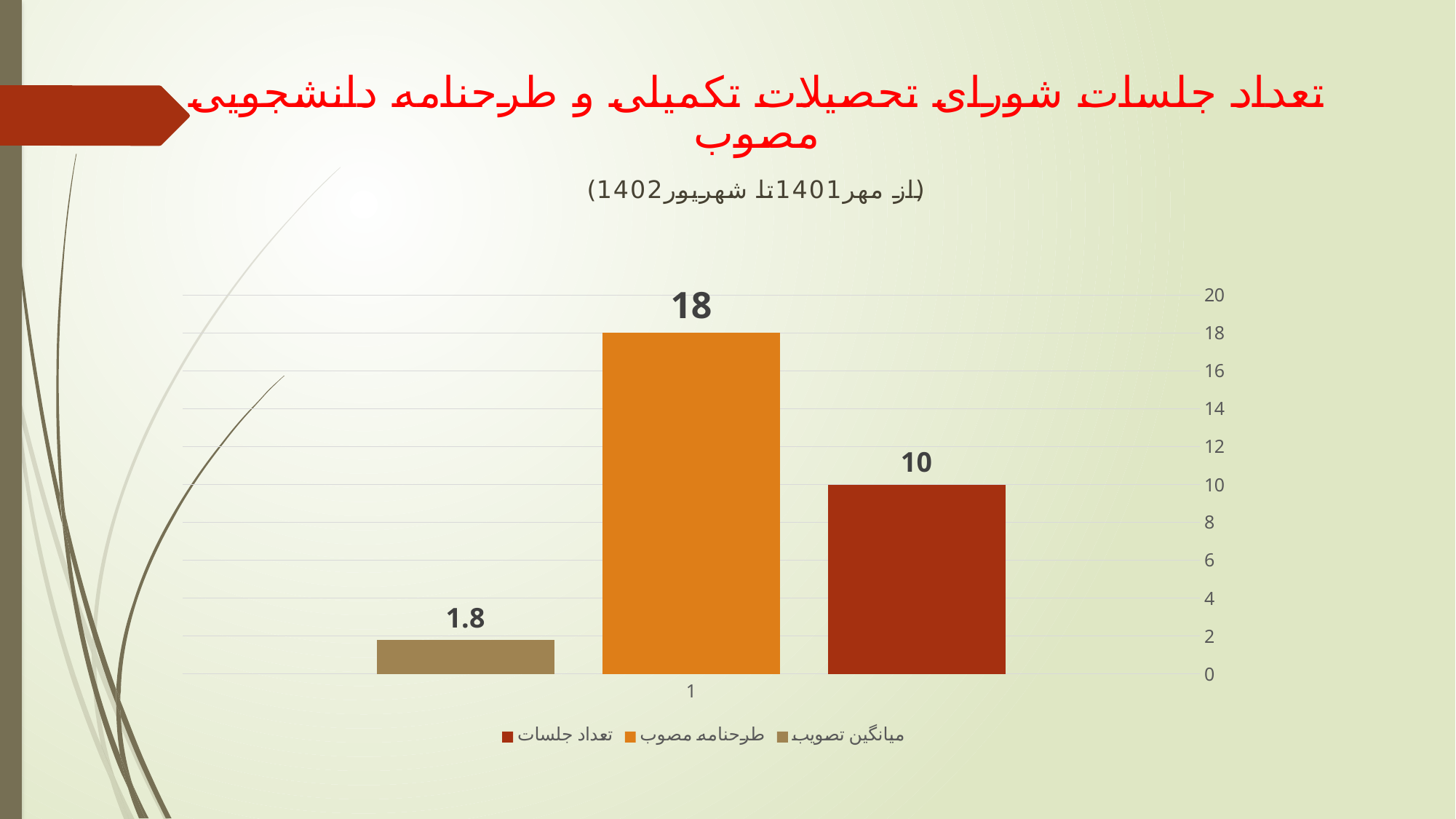
Which series has the lowest value? میانگین تصویب What is the value of the تعداد جلسات series? 10 What is the highest value shown on the vertical axis? 20 Which series has the highest value? طرحنامه مصوب What is the difference between the تعداد جلسات value and the میانگین تصویب value? 8.2 Which is larger, the value for تعداد جلسات or the value for میانگین تصویب? تعداد جلسات What is the value of the طرحنامه مصوب series? 18 What is the value of the میانگین تصویب series? 1.8 What is the difference between the طرحنامه مصوب value and the تعداد جلسات value? 8 What colour is the bar for طرحنامه مصوب? orange How many series does the legend list? 3 What type of chart is shown on the slide? bar chart